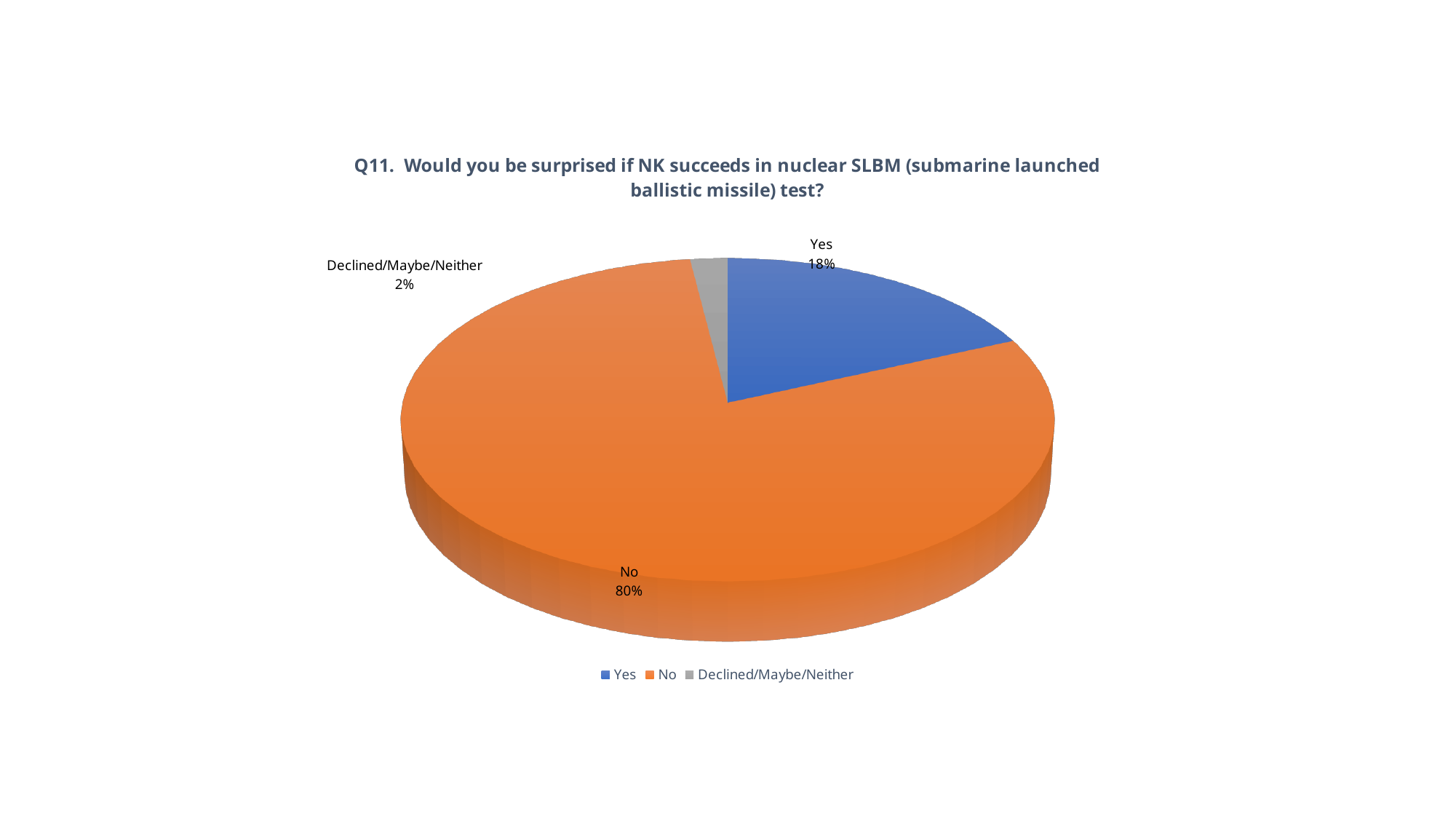
What colour is the "No" slice? Orange What is the question number shown at the start of the chart title? Q11 Which is larger, the "Yes" slice or the "Declined/Maybe/Neither" slice? Yes What kind of chart is shown on the slide? Pie chart How many entries does the legend list? 3 Which response has the smallest slice of the pie? Declined/Maybe/Neither What percentage of respondents answered "No"? 80% What percentage of respondents answered "Yes"? 18% What is the difference in percentage points between "No" and "Yes"? 62 What share of the pie is "Declined/Maybe/Neither"? 2% How many slices does the pie chart have? 3 Which response has the largest slice of the pie? No